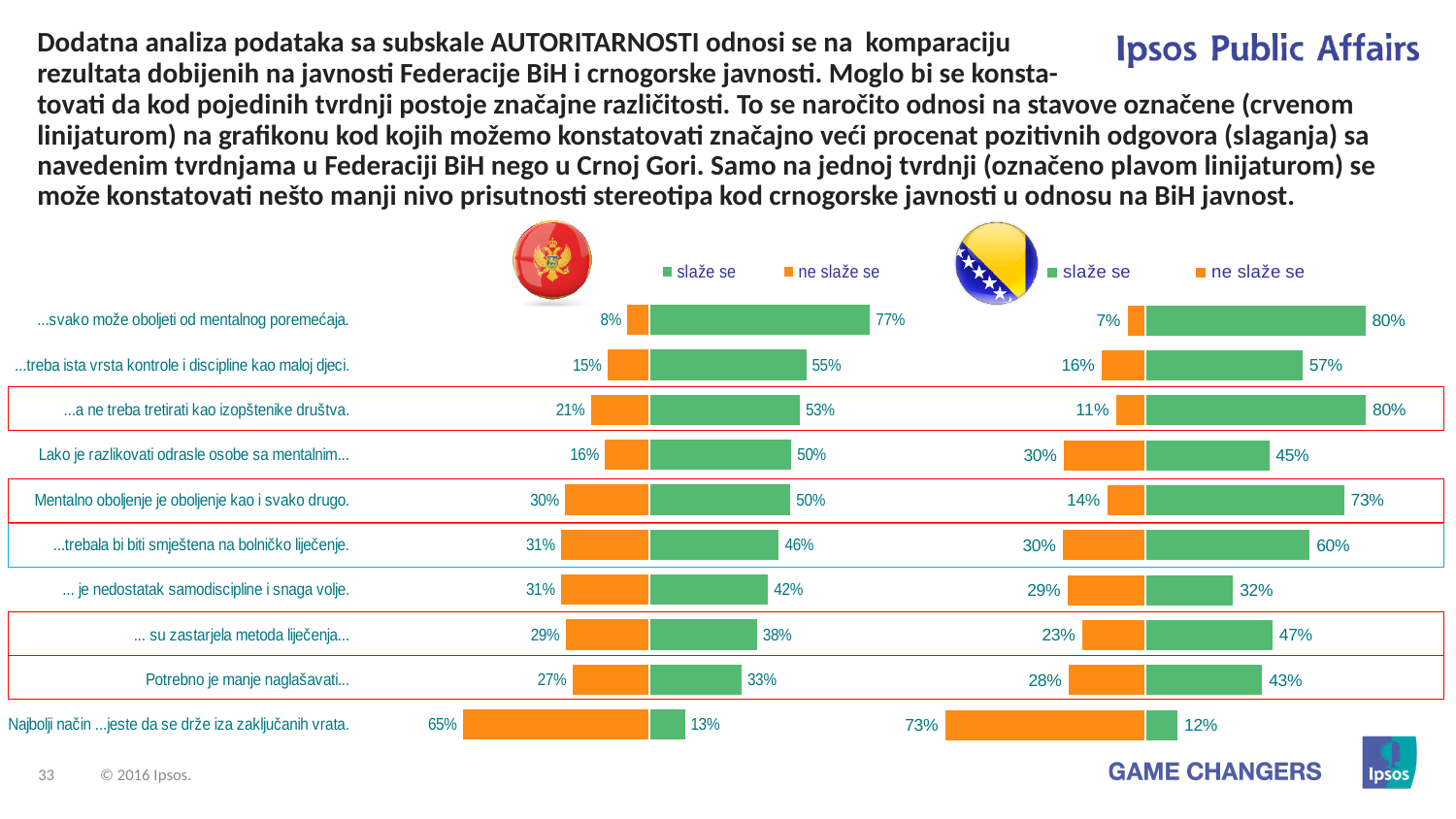
How many categories are shown in the left chart? 10 Which chart shows a larger 'slaže se' value for '...trebala bi biti smještena na bolničko liječenje.', the left chart or the right chart? the right chart In the left chart, which category has the highest 'ne slaže se' value? Najbolji način ...jeste da se drže iza zaključanih vrata. In the right chart, which category has the lowest 'slaže se' value? Najbolji način ...jeste da se drže iza zaključanih vrata. In the left chart, what is the 'slaže se' value for '...svako može oboljeti od mentalnog poremećaja.'? 77% In the right chart, what is the 'ne slaže se' value for 'Lako je razlikovati odrasle osobe sa mentalnim...'? 30% What type of chart is the left chart? bar chart In the right chart, what is the difference between the 'slaže se' and 'ne slaže se' values for '...a ne treba tretirati kao izopštenike društva.'? 69% In the left chart, which colour represents the 'ne slaže se' series? orange In the left chart, what is the difference between the 'slaže se' values for '...svako može oboljeti od mentalnog poremećaja.' and 'Potrebno je manje naglašavati...'? 44% How many series does the legend of the right chart list? 2 In the right chart, what is the 'slaže se' value for 'Mentalno oboljenje je oboljenje kao i svako drugo.'? 73%